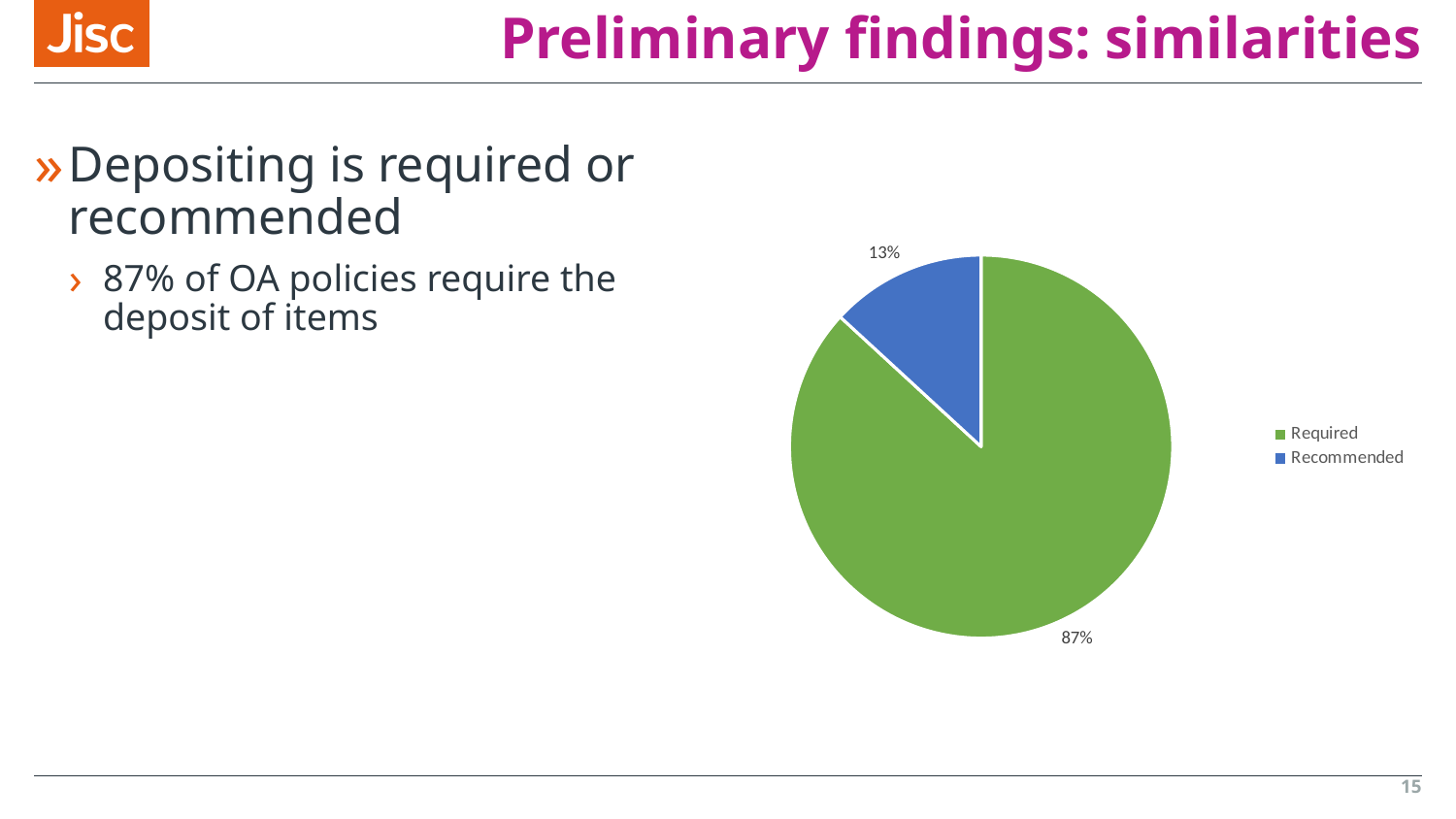
How many slices does the pie chart have? 2 Which is larger, the Required slice or the Recommended slice? Required Which slice of the pie is the smallest? Recommended Which slice of the pie is the largest? Required What kind of chart is shown on the slide? pie chart What colour is the Recommended slice? blue What percentage of the pie is labelled Required? 87% What percentage of the pie is labelled Recommended? 13% How many entries does the legend list? 2 What colour is the Required slice? green What share of the pie does the Recommended slice take? 13% What is the difference in percentage points between the Required and Recommended slices? 74